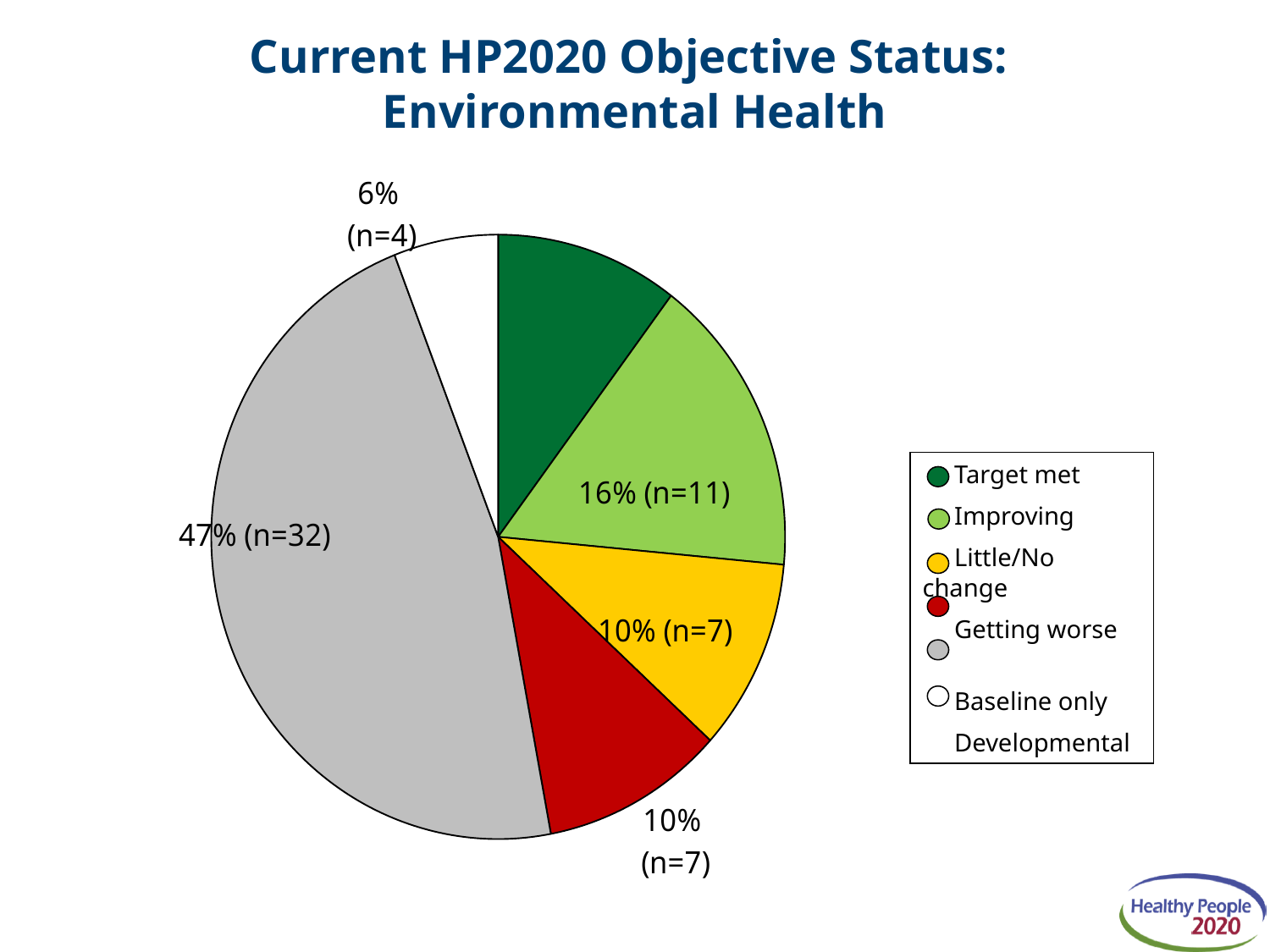
Which category has the largest share of the pie? Baseline only How many categories does the legend list? 6 What percentage of objectives are Developmental? 6% What percentage of objectives show Little/No change? 10% What type of chart is shown on the slide? Pie chart What percentage of Environmental Health objectives are in the Improving category? 16% Which category has the smallest share of the pie? Developmental How many objectives (n) are in the Getting worse category? 7 What is the difference in percentage points between the Baseline only share and the Improving share? 31 percentage points Which category has a larger share: Improving or Little/No change? Improving How many objectives (n) are in the Baseline only category? 32 What is the title of the chart? Current HP2020 Objective Status: Environmental Health